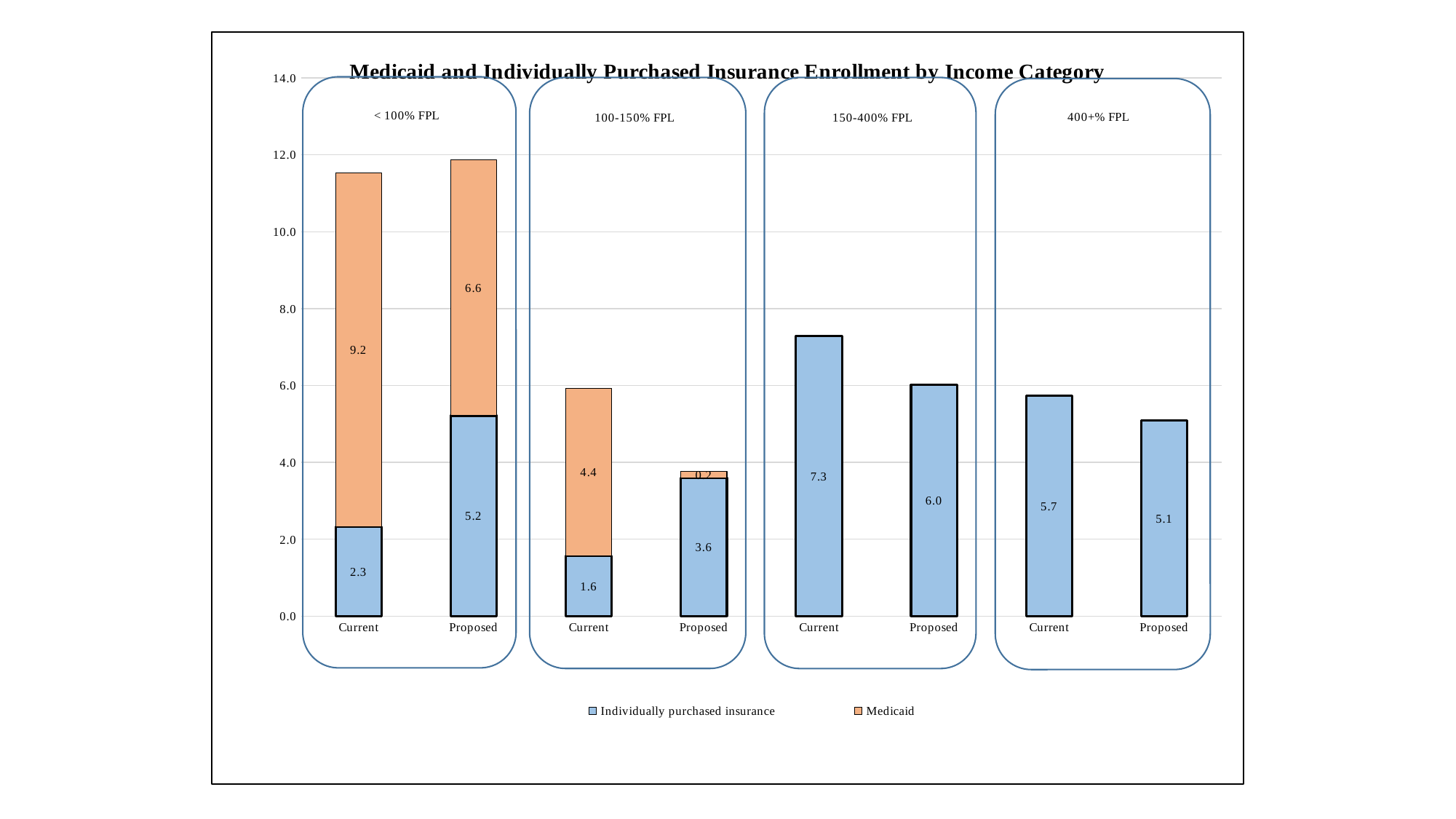
What is the Medicaid value for the Proposed bar in the 100-150% FPL group? 0.2 What is the total of the stacked Proposed bar in the 100-150% FPL group? 3.8 Is the total of the Current bar in the 100-150% FPL group greater or less than 4.0? greater What is the total of the stacked Current bar in the < 100% FPL group? 11.5 What is the Medicaid value for the Current bar in the < 100% FPL group? 9.2 What is the Individually purchased insurance value for the Proposed bar in the 100-150% FPL group? 3.6 What is the value for the Current bar in the 150-400% FPL group? 7.3 Which bar has the highest Medicaid value? Current in < 100% FPL What kind of chart is shown on the slide? Stacked bar chart Which has the larger Individually purchased insurance value in the < 100% FPL group, Current or Proposed? Proposed How many series does the legend list? 2 What is the difference between the Current and Proposed values in the 400+% FPL group? 0.6